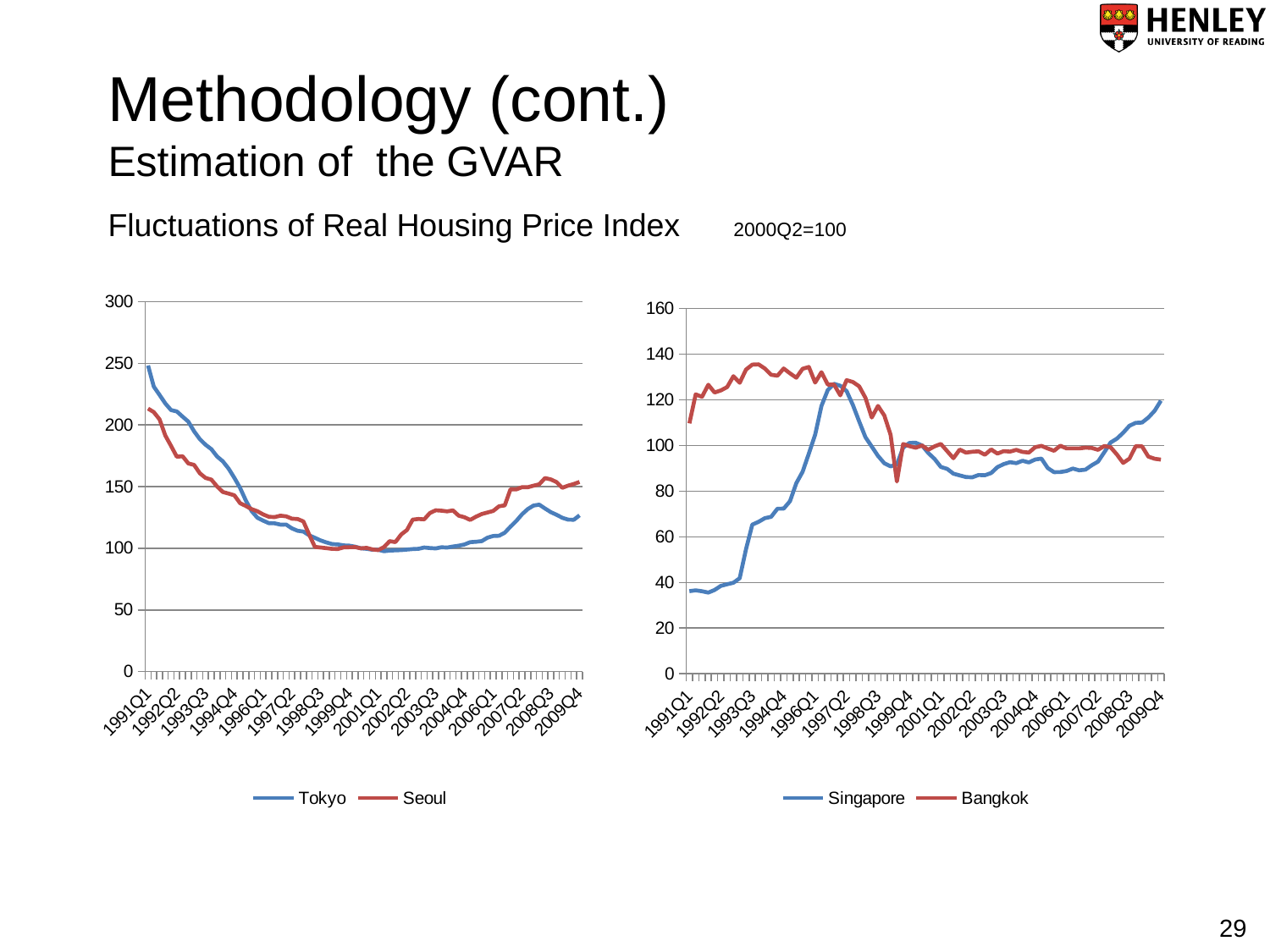
How many series does the legend of the right chart (Singapore and Bangkok) list? 2 In the left chart, does the Tokyo series rise or fall from 1991Q1 to 2001Q1? fall In the left chart, is the value for Tokyo at 1991Q1 greater or less than 200? greater In the right chart, does the Singapore series rise or fall from 1991Q1 to 1997Q2? rise In the right chart, which series is higher at 1991Q1, Singapore or Bangkok? Bangkok What kind of chart is the left chart (Tokyo and Seoul)? line chart In the left chart, which series is higher at 2009Q4, Tokyo or Seoul? Seoul In the left chart, which series is higher at 1991Q1, Tokyo or Seoul? Tokyo In the right chart, is the value for Singapore at 1991Q1 greater or less than 40? less In the left chart, which two series are listed in the legend? Tokyo and Seoul In the right chart, is the value for Singapore at 2009Q4 greater or less than 100? greater